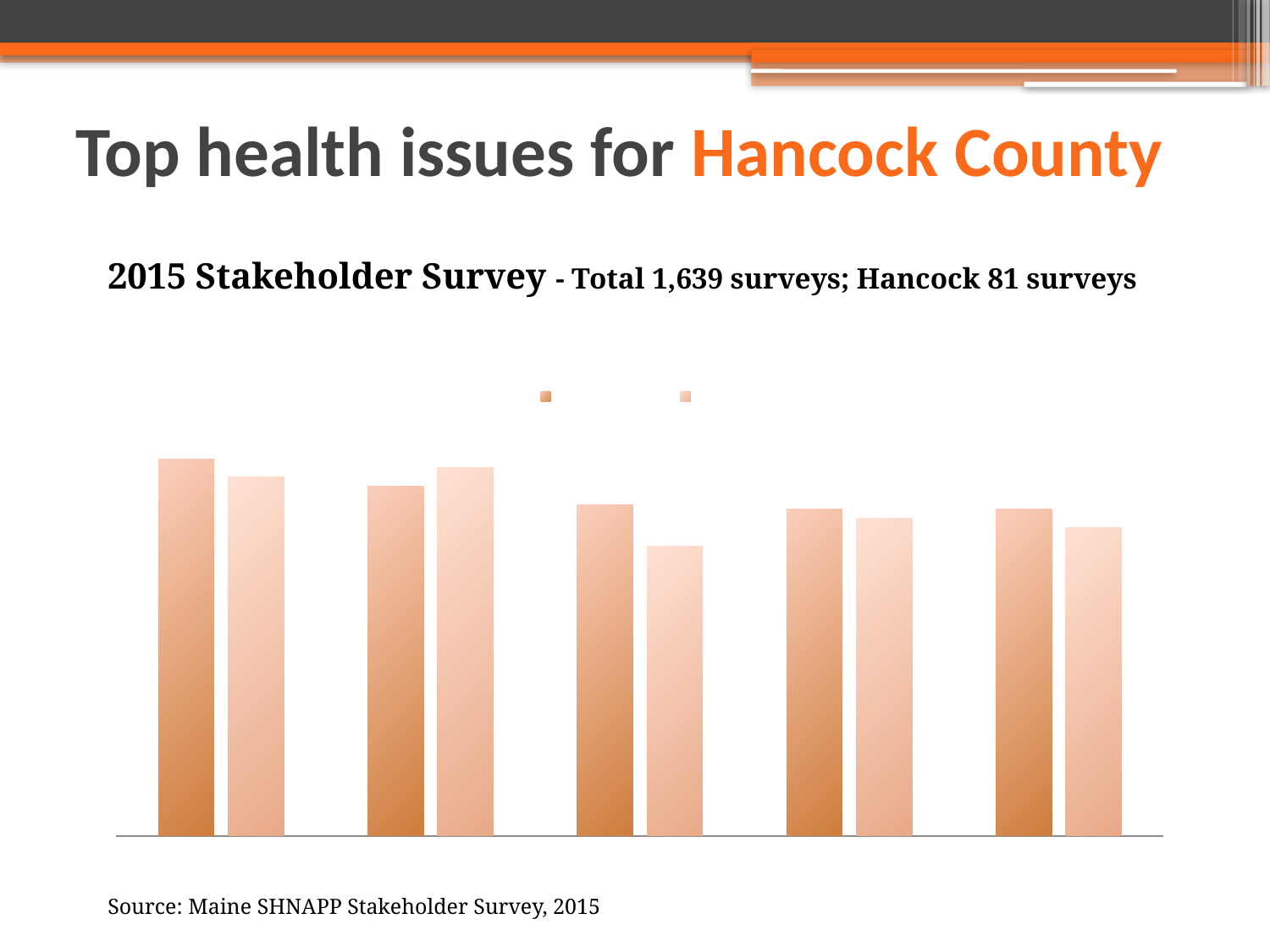
Which is taller, the lighter orange bar in the third group or the lighter orange bar in the fifth group? the lighter orange bar in the fifth group Where is the legend positioned relative to the bars? above the bars In the leftmost group of bars, which bar is taller, the darker orange bar or the lighter orange bar? the darker orange bar Which group of bars contains the tallest bar in the chart? the leftmost group What colours are the two series of bars in the chart? darker orange and lighter orange Which bar is the shortest in the chart? the lighter orange bar in the third group from the left What kind of chart is shown on the slide? bar chart In the third group of bars from the left, which bar is taller, the darker orange bar or the lighter orange bar? the darker orange bar How many series does the chart's legend list? 2 How many groups of bars are plotted in the chart? 5